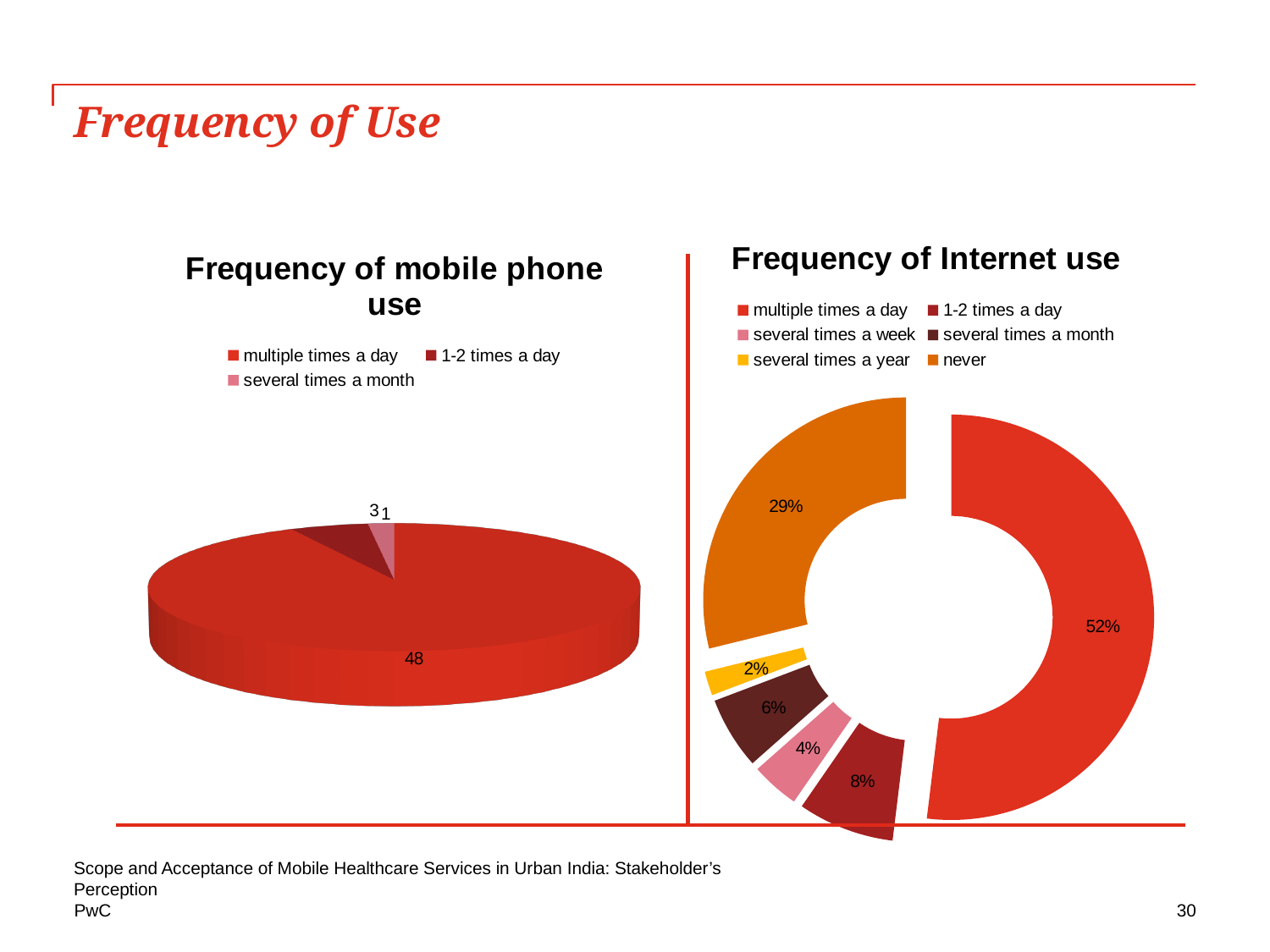
In the 'Frequency of Internet use' chart, which category has the smallest share? several times a year What type of chart is the 'Frequency of Internet use' chart? doughnut chart In the 'Frequency of mobile phone use' chart, which category has the largest value? multiple times a day In the 'Frequency of mobile phone use' chart, what is the value for '1-2 times a day'? 3 In the 'Frequency of Internet use' chart, what percentage is shown for 'several times a year'? 2% In the 'Frequency of mobile phone use' chart, what is the difference between 'multiple times a day' and '1-2 times a day'? 45 In the 'Frequency of mobile phone use' chart, how many categories does the legend list? 3 In the 'Frequency of mobile phone use' chart, what is the value for 'several times a month'? 1 In the 'Frequency of Internet use' chart, which is larger: '1-2 times a day' or 'several times a month'? 1-2 times a day In the 'Frequency of Internet use' chart, what percentage is shown for 'multiple times a day'? 52% In the 'Frequency of mobile phone use' chart, what is the value for 'multiple times a day'? 48 In the 'Frequency of Internet use' chart, what percentage is shown for 'never'? 29%